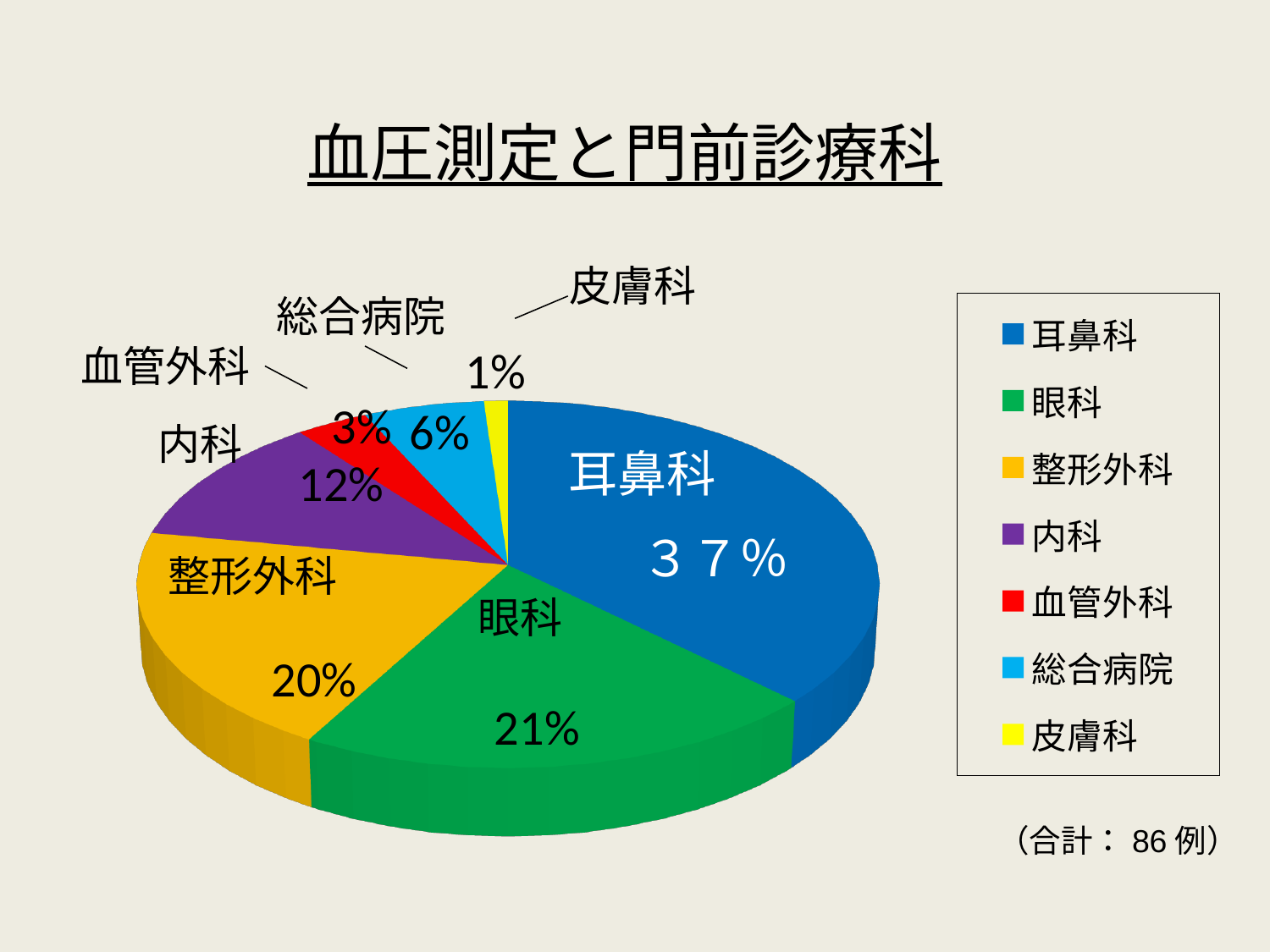
What share of the pie does 整形外科 represent? 20% What share of the pie does 耳鼻科 represent? 37% What share of the pie does 皮膚科 represent? 1% What is the difference in percentage points between 耳鼻科 and 眼科? 16 Which category has the smallest slice of the pie? 皮膚科 How many categories does the legend list? 7 Which category has the largest slice of the pie? 耳鼻科 What kind of chart is shown on the slide? pie chart Which is larger, the share for 内科 or the share for 総合病院? 内科